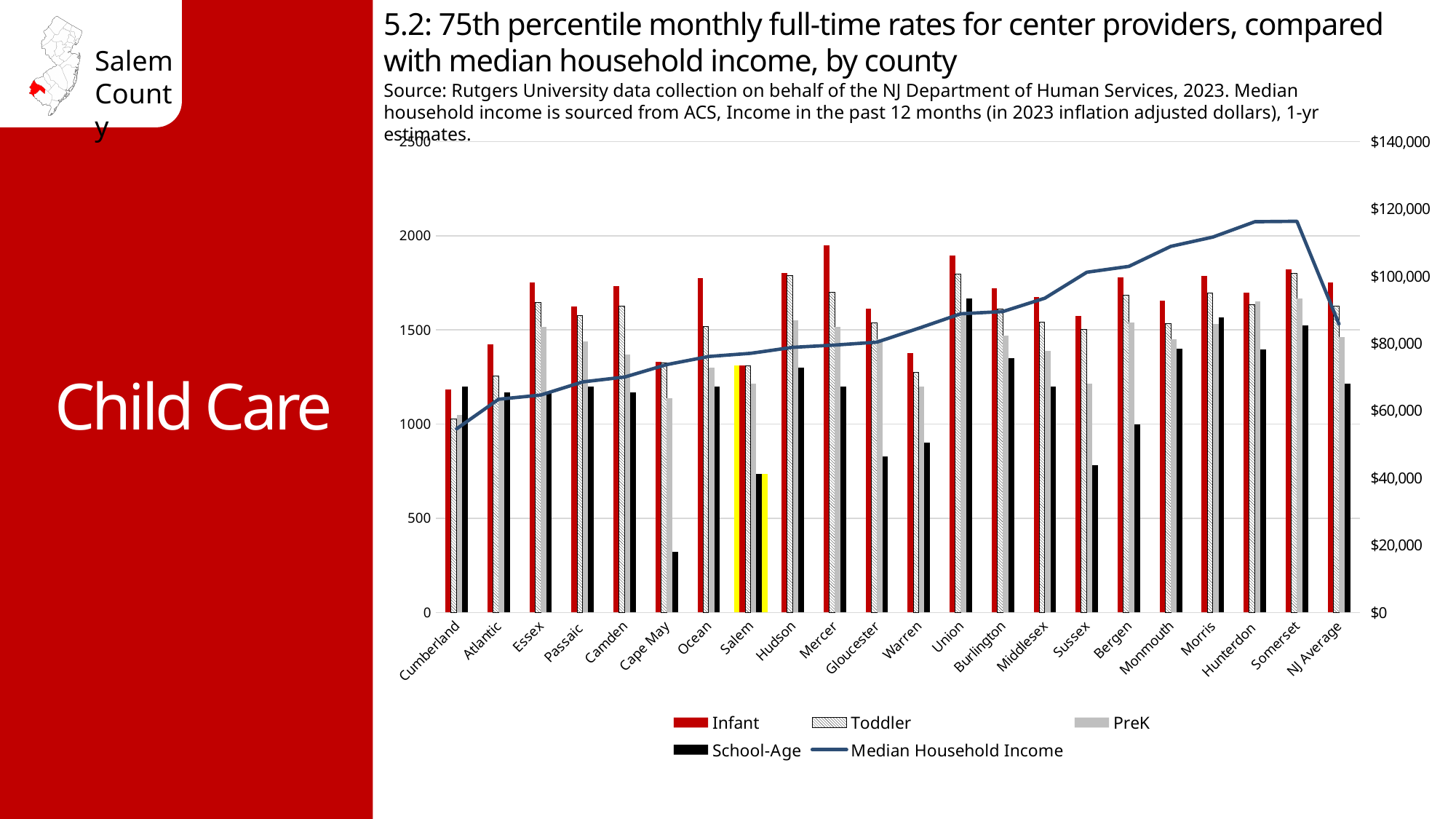
What kind of chart is shown on the slide? Bar chart with a line Is the School-Age rate for Salem greater or less than 1000? less Which county has the lowest Median Household Income? Cumberland Which county has the lowest Infant rate? Cumberland How many counties/categories are shown on the x axis of the chart? 22 Which is larger, the Infant rate for Mercer or the Infant rate for Cumberland? Mercer Which county has the lowest School-Age rate? Cape May Which county has the highest Infant rate? Mercer How many series does the chart's legend list? 5 Is the Median Household Income for Somerset greater or less than $100,000? greater Is the Infant rate for Salem greater or less than 1000? greater Does the Median Household Income line generally rise or fall from Cumberland to Somerset? rise